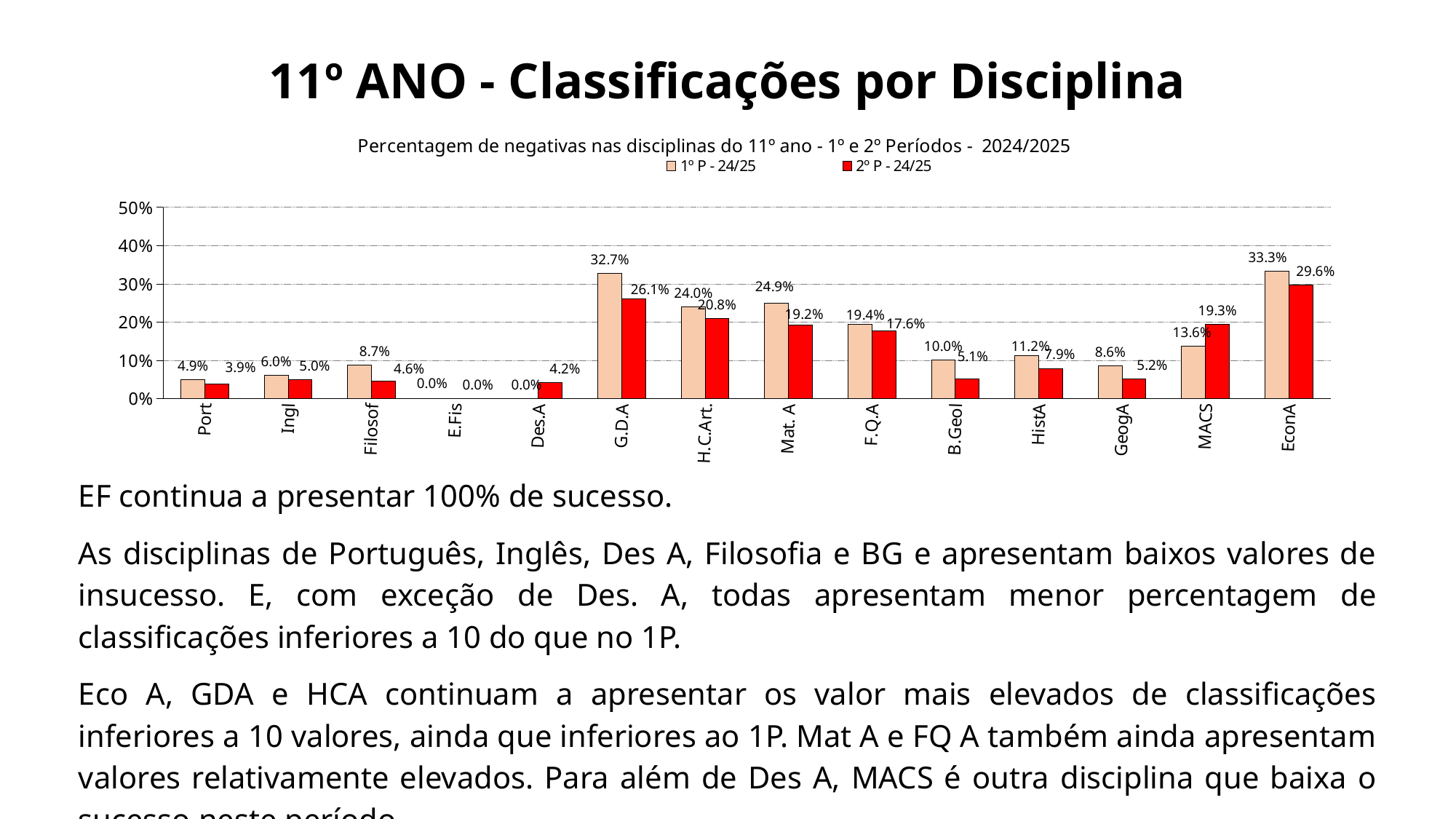
What is the value for G.D.A in the 1º P - 24/25 series? 32.7% What is the value for Filosof in the 2º P - 24/25 series? 4.6% Is the 2º P - 24/25 value for EconA greater or less than 20%? greater What colour are the bars for the 2º P - 24/25 series? Red What is the difference between the 1º P - 24/25 and 2º P - 24/25 values for G.D.A? 6.6 percentage points What is the value for MACS in the 2º P - 24/25 series? 19.3% Which discipline has the highest value in the 1º P - 24/25 series? EconA How many series does the legend list? 2 What type of chart is shown on the slide? Bar chart For MACS, which series has the larger value: 1º P - 24/25 or 2º P - 24/25? 2º P - 24/25 How many disciplines (categories) are shown on the x axis? 14 Which discipline has the lowest value in the 2º P - 24/25 series? E.Fis